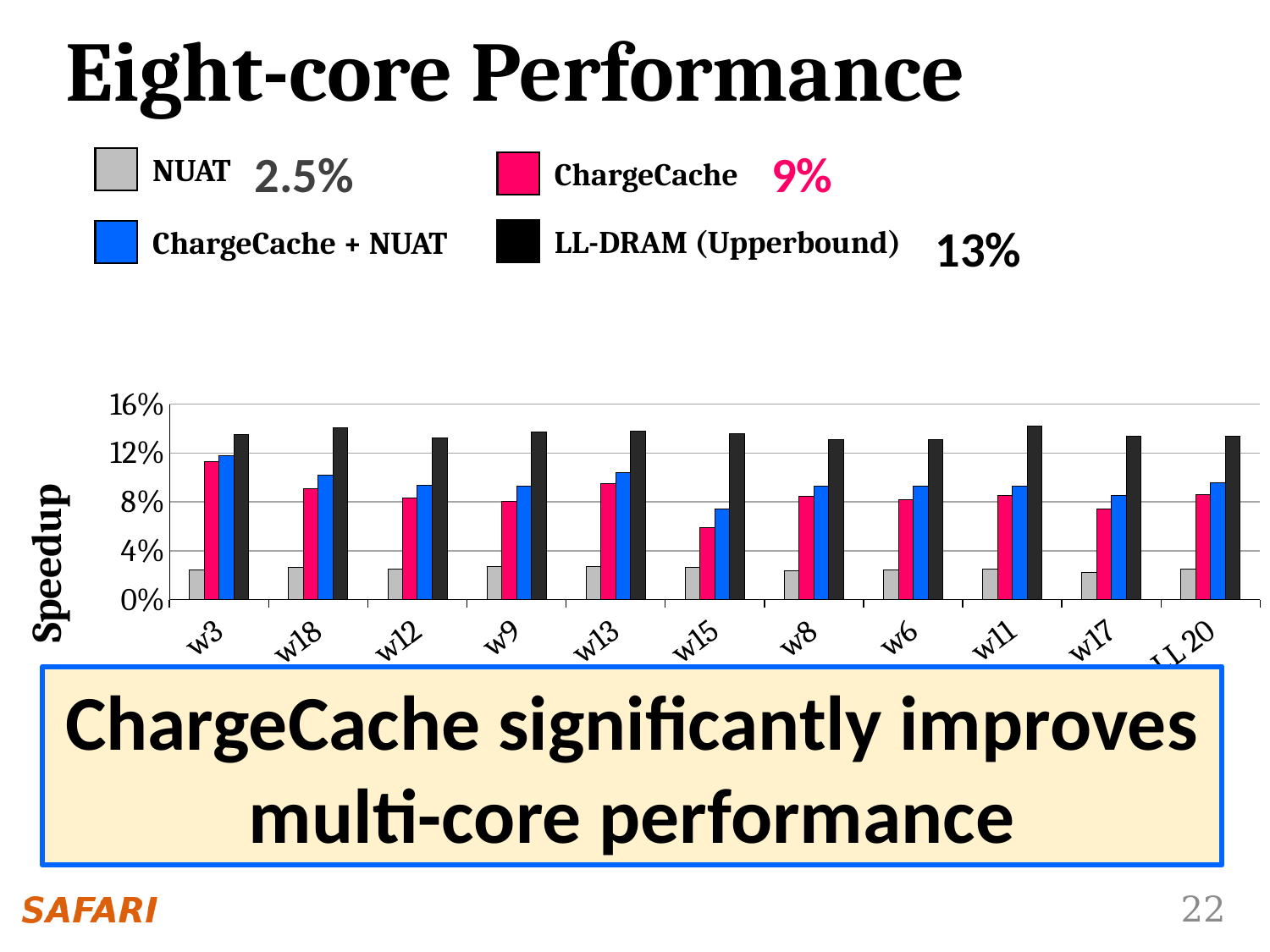
For w3, which is larger: the ChargeCache speedup or the LL-DRAM (Upperbound) speedup? LL-DRAM (Upperbound) Which workload has the lowest ChargeCache speedup? w15 What kind of chart is shown on the slide? bar chart Is the LL-DRAM (Upperbound) speedup for w18 greater or less than 12%? greater How many series does the legend list? 4 How many groups of bars are plotted along the x axis? 11 What is the label of the y axis? Speedup Is the NUAT speedup for w9 greater or less than 4%? less Is the ChargeCache speedup for w3 greater or less than 8%? greater Which workload has the highest ChargeCache speedup? w3 What average speedup value is printed next to ChargeCache in the legend? 9%